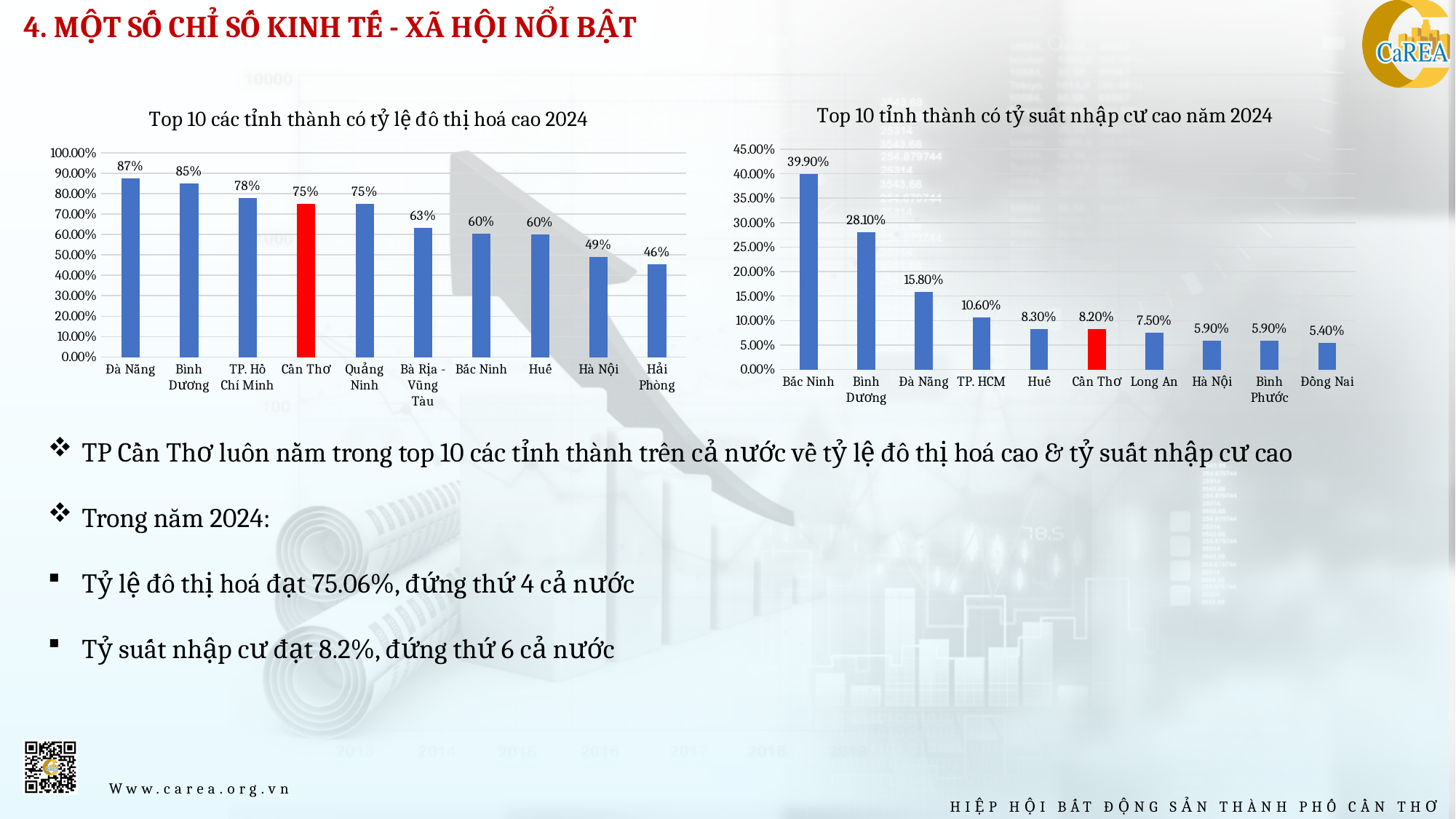
In the chart 'Top 10 các tỉnh thành có tỷ lệ đô thị hoá cao 2024', what is the difference between Đà Nẵng and Hà Nội? 38% In the chart 'Top 10 tỉnh thành có tỷ suất nhập cư cao năm 2024', which is larger, Đà Nẵng or TP. HCM? Đà Nẵng In the chart 'Top 10 tỉnh thành có tỷ suất nhập cư cao năm 2024', which province has the highest value? Bắc Ninh In the chart 'Top 10 tỉnh thành có tỷ suất nhập cư cao năm 2024', what is the value for Bắc Ninh? 39.90% In the chart 'Top 10 các tỉnh thành có tỷ lệ đô thị hoá cao 2024', which bar is coloured red? Cần Thơ In the chart 'Top 10 tỉnh thành có tỷ suất nhập cư cao năm 2024', what is the value for Cần Thơ? 8.20% What kind of chart is 'Top 10 tỉnh thành có tỷ suất nhập cư cao năm 2024'? Bar chart In the chart 'Top 10 tỉnh thành có tỷ suất nhập cư cao năm 2024', what is the difference between Bắc Ninh and Bình Dương? 11.80% In the chart 'Top 10 các tỉnh thành có tỷ lệ đô thị hoá cao 2024', which province has the lowest value? Hải Phòng In the chart 'Top 10 các tỉnh thành có tỷ lệ đô thị hoá cao 2024', what is the value for Đà Nẵng? 87% In the chart 'Top 10 các tỉnh thành có tỷ lệ đô thị hoá cao 2024', what is the value for Cần Thơ? 75% In the chart 'Top 10 các tỉnh thành có tỷ lệ đô thị hoá cao 2024', how many provinces are shown? 10